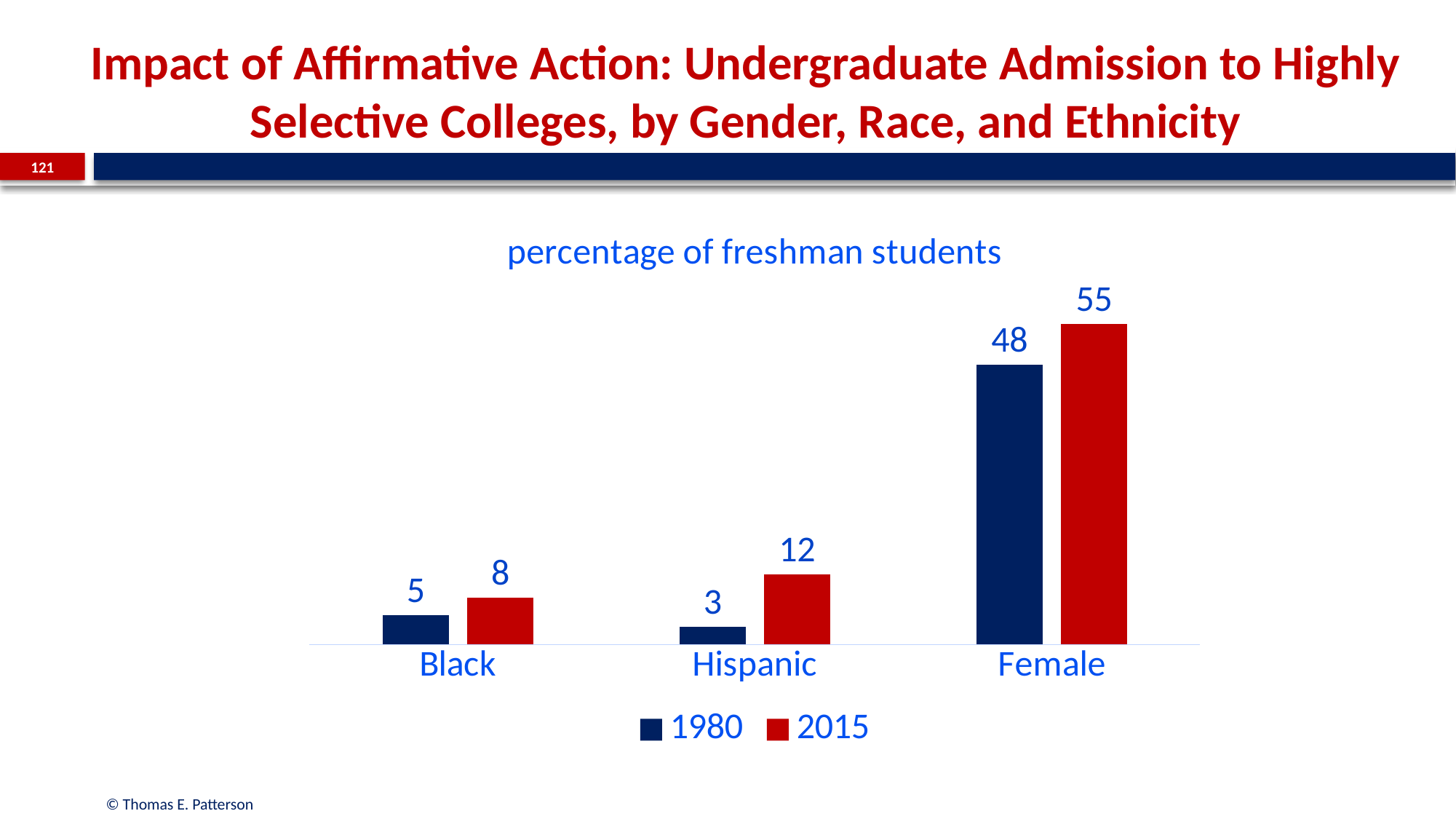
Which is larger, the 2015 value for Black or the 2015 value for Hispanic? Hispanic What is the value for Hispanic in 2015? 12 Which category has the highest value in 2015? Female What is the value for Black in 1980? 5 What kind of chart is shown on the slide? Bar chart How many categories are shown on the x axis? 3 What is the value for Female in 1980? 48 How many series does the legend list? 2 What is the difference between the 2015 and 1980 values for Female? 7 Which category has the lowest value in 1980? Hispanic What is the chart's title? percentage of freshman students What is the difference between the 2015 and 1980 values for Hispanic? 9